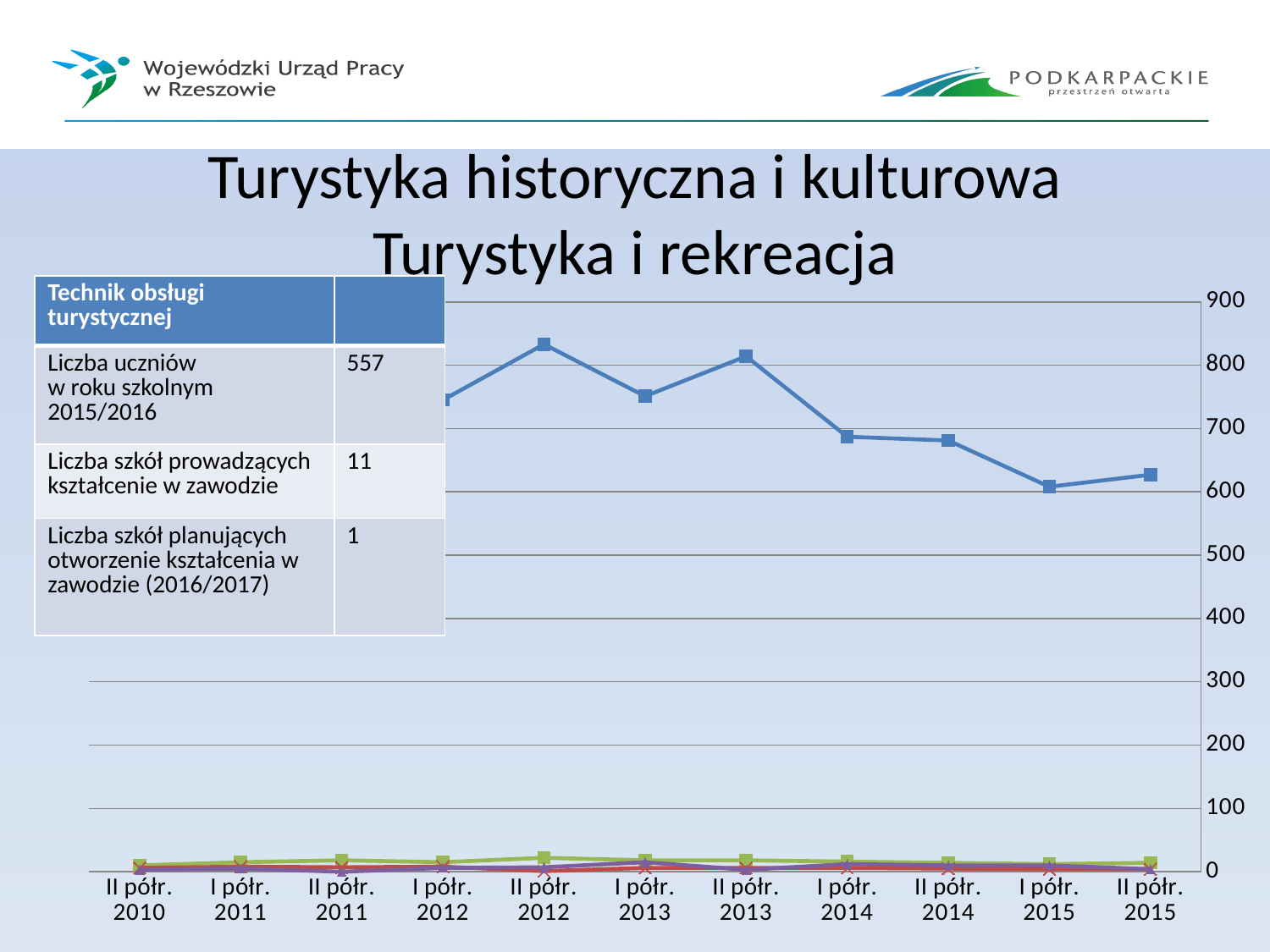
Is the value of the blue line for I półr. 2015 greater or less than 700? less How many time periods are shown on the x axis of the chart? 11 Is the value of the blue line for II półr. 2013 greater or less than 700? greater Which period is the first category on the x axis of the chart? II półr. 2010 Is the value of the blue line for II półr. 2015 greater or less than 700? less Which is larger on the blue line: the value for II półr. 2012 or the value for I półr. 2013? II półr. 2012 What kind of chart is shown on the slide? line chart Among the visible points of the blue line, which period has the lowest value? I półr. 2015 What is the highest value shown on the chart's vertical axis? 900 Among the visible points of the blue line, which period has the highest value? II półr. 2012